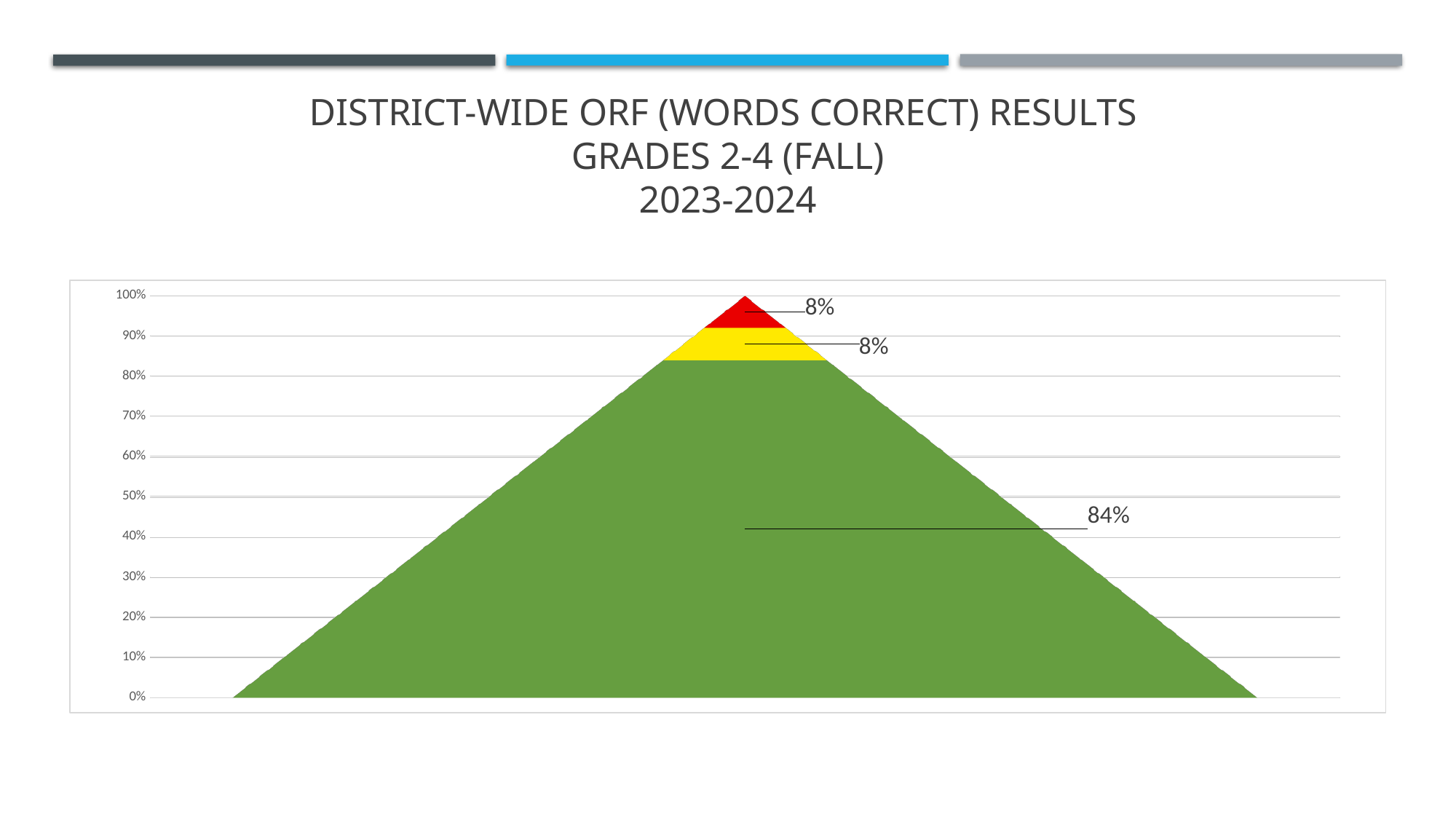
Is the value of the red segment greater or less than 10%? less What percentage does the green segment of the chart represent? 84% What percentage does the yellow segment of the chart represent? 8% Which school year does the chart title say the results are for? 2023-2024 Which coloured segment of the chart has the largest share? Green (84%) What percentage does the red segment at the top of the chart represent? 8% What is the difference between the green segment's value and the red segment's value? 76% Which is larger, the green segment or the yellow segment? Green What is the total of the three segment values shown on the chart? 100% Which is larger, the red segment or the yellow segment? They are equal (both 8%) How many coloured segments make up the chart? 3 Is the value of the green segment greater or less than 80%? greater